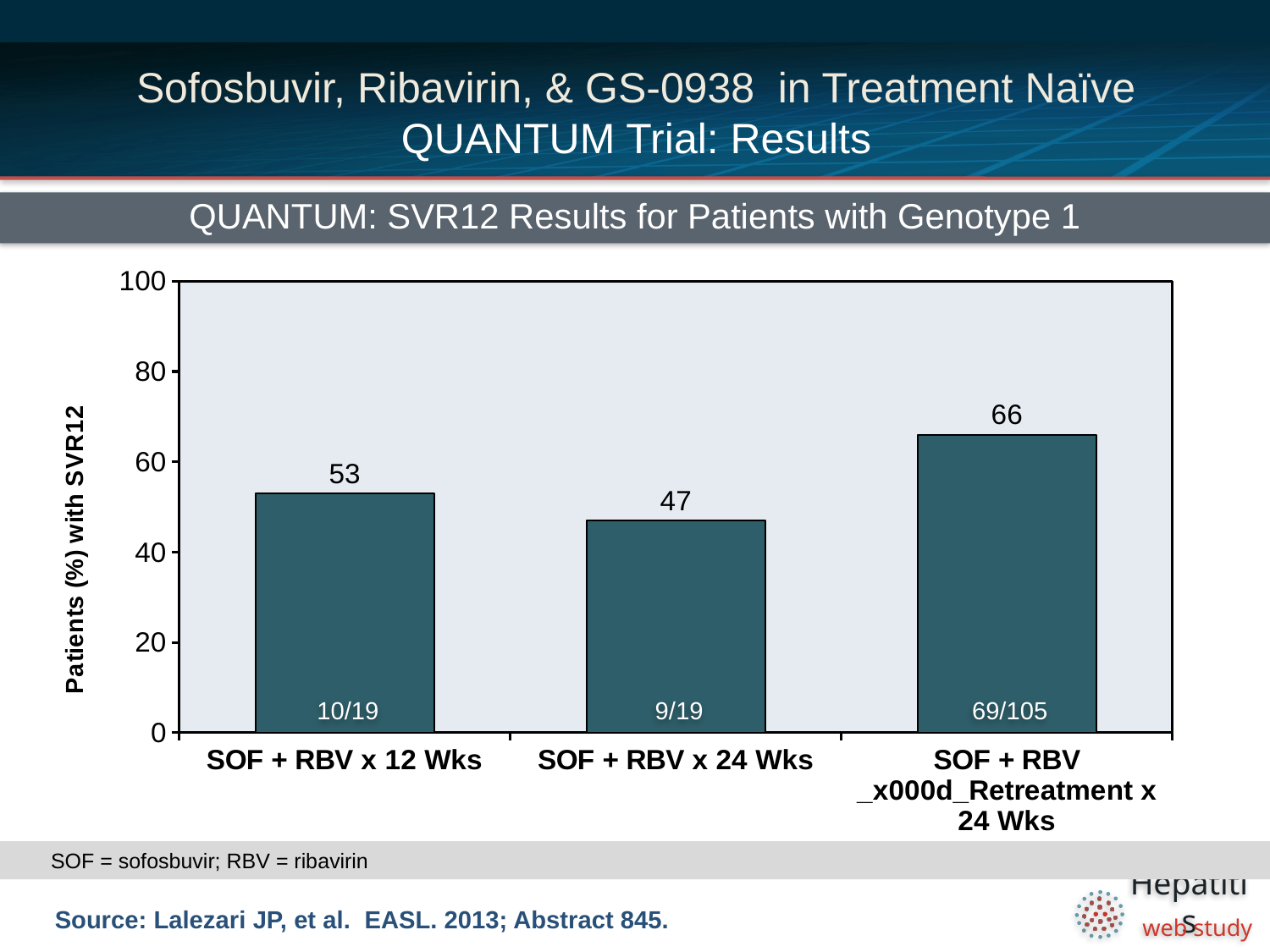
What is the difference in SVR12 rate between SOF + RBV Retreatment x 24 Wks and SOF + RBV x 24 Wks? 19 What is the SVR12 rate (%) for SOF + RBV x 12 Wks? 53 What fraction of patients achieved SVR12 in the SOF + RBV Retreatment x 24 Wks group, as printed inside the bar? 69/105 What is the SVR12 rate (%) for SOF + RBV Retreatment x 24 Wks? 66 Which treatment group has the highest SVR12 rate? SOF + RBV Retreatment x 24 Wks What is the label of the y-axis? Patients (%) with SVR12 Which has a higher SVR12 rate: SOF + RBV x 12 Wks or SOF + RBV x 24 Wks? SOF + RBV x 12 Wks How many treatment groups are shown in the chart? 3 Which treatment group has the lowest SVR12 rate? SOF + RBV x 24 Wks What kind of chart is shown on the slide? Bar chart What fraction of patients achieved SVR12 in the SOF + RBV x 12 Wks group, as printed inside the bar? 10/19 What is the SVR12 rate (%) for SOF + RBV x 24 Wks? 47